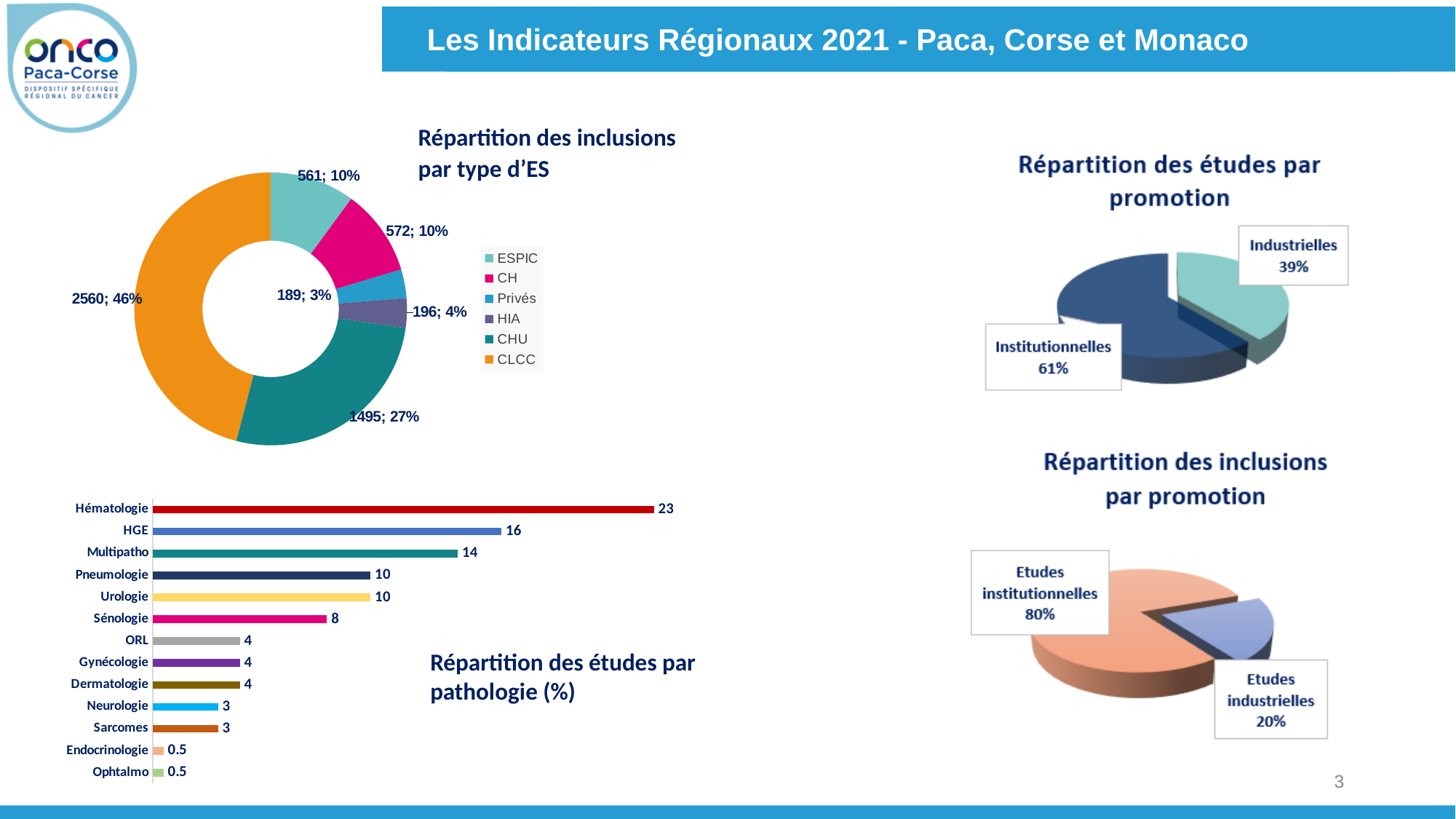
In the chart 'Répartition des inclusions par type d'ES', how many entries does the legend list? 6 In the chart 'Répartition des inclusions par type d'ES', which type of ES has the smallest number of inclusions? Privés In the chart 'Répartition des inclusions par type d'ES', which type of ES has the largest share? CLCC In the chart 'Répartition des études par promotion', what share is Industrielles? 39% In the chart 'Répartition des études par pathologie (%)', what is the difference between Hématologie and Sénologie? 15 What kind of chart is 'Répartition des études par pathologie (%)'? Bar chart In the chart 'Répartition des études par pathologie (%)', what is the value for Hématologie? 23 In the chart 'Répartition des études par pathologie (%)', how many pathology categories are shown? 13 In the chart 'Répartition des études par pathologie (%)', which is larger, HGE or Multipatho? HGE In the chart 'Répartition des inclusions par type d'ES', what value is shown for CLCC? 2560; 46% In the chart 'Répartition des inclusions par promotion', what share is Etudes institutionnelles? 80% In the chart 'Répartition des inclusions par type d'ES', what is the difference between the CHU and CH inclusion counts? 923